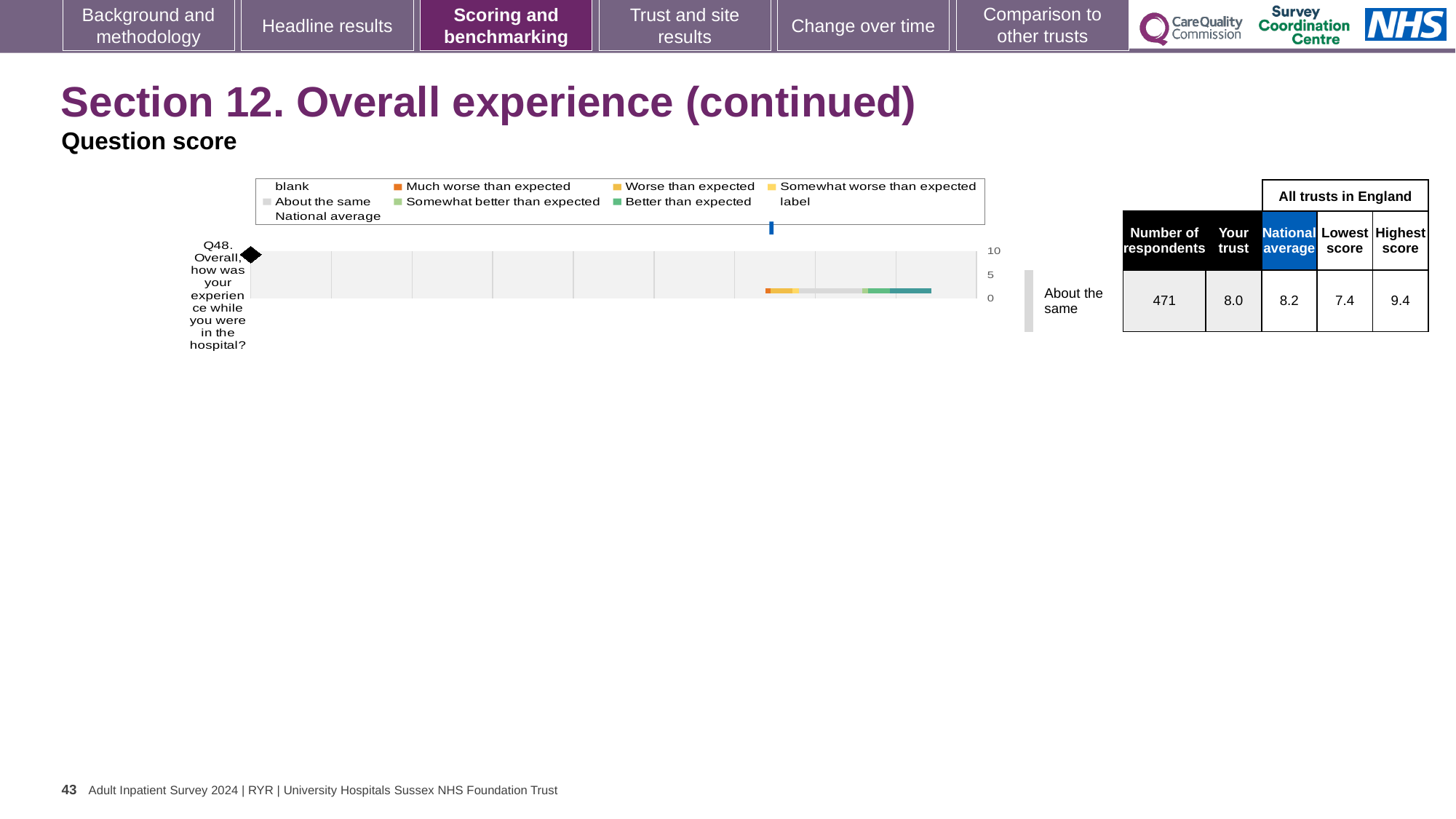
What is the highest score among all trusts in England for Q48? 9.4 What kind of chart is shown on the slide? bar chart What is the lowest score among all trusts in England for Q48? 7.4 Which is larger for Q48, the 'Your trust' score or the national average? National average How many questions (categories) are plotted in the chart? 1 What is the number of respondents for Q48 shown in the table beside the chart? 471 What is the difference between the national average (8.2) and the 'Your trust' score (8.0) for Q48? 0.2 What is the 'Your trust' score for Q48 shown in the table beside the chart? 8.0 How many entries does the chart legend list? 9 What is the national average score for Q48 shown in the table beside the chart? 8.2 Which benchmark category is the trust's Q48 score placed in? About the same Which question is plotted in the chart? Q48. Overall, how was your experience while you were in the hospital?